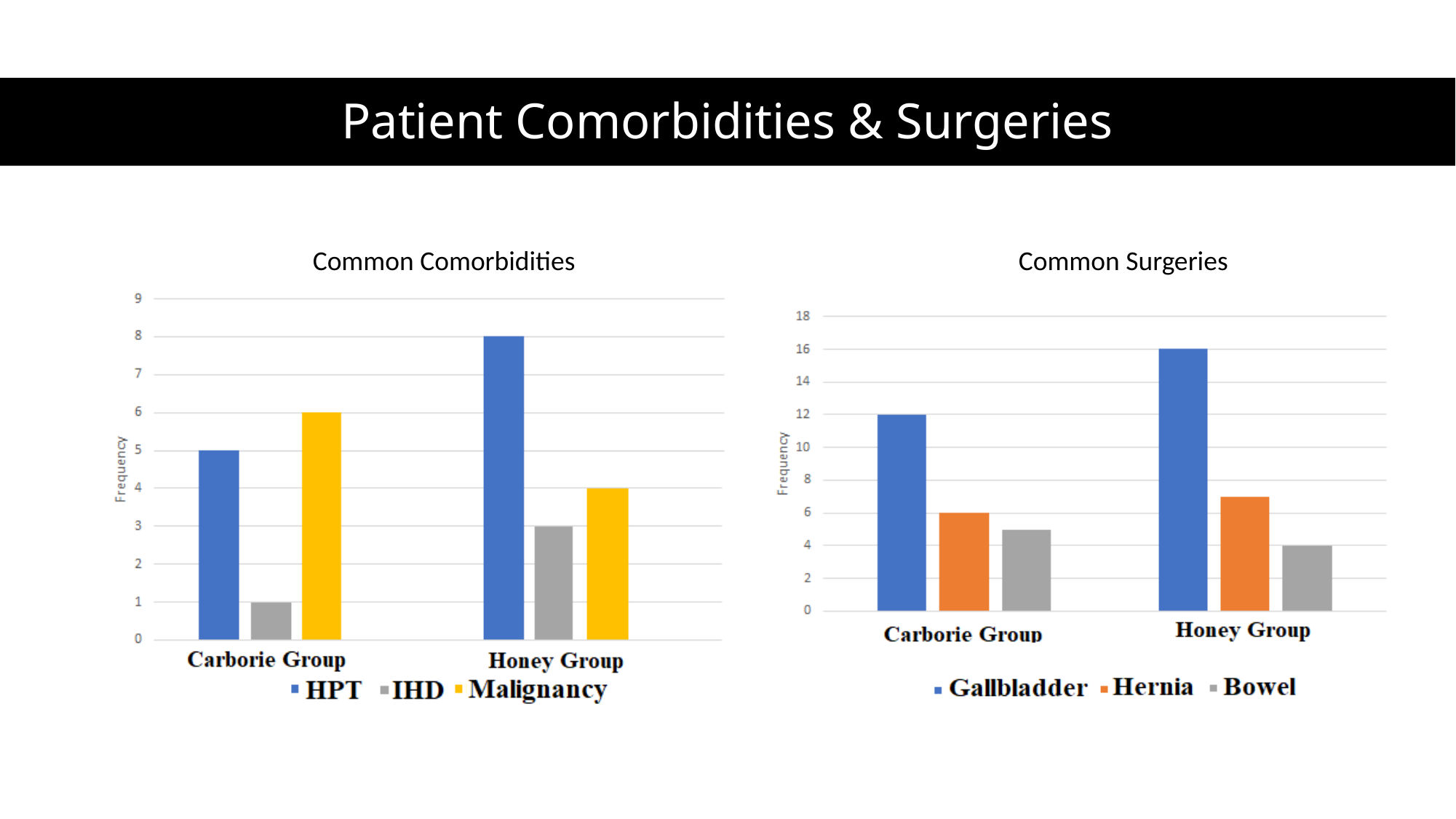
In the Common Surgeries chart, what is the difference between the Gallbladder values for the Honey Group and the Carborie Group? 4 In the Common Surgeries chart, is the Hernia value for the Honey Group greater or less than 6? greater In the Common Comorbidities chart, what is the IHD value for the Carborie Group? 1 In the Common Surgeries chart, what is the Hernia value for the Carborie Group? 6 In the Common Comorbidities chart, what is the Malignancy value for the Carborie Group? 6 What kind of chart is the Common Surgeries chart? Bar chart In the Common Comorbidities chart, how many series does the legend list? 3 In the Common Surgeries chart, which series has the highest value for the Carborie Group? Gallbladder In the Common Comorbidities chart, what is the difference between the HPT values for the Honey Group and the Carborie Group? 3 In the Common Comorbidities chart, which series has the lowest value for the Honey Group? IHD In the Common Surgeries chart, what is the Gallbladder value for the Honey Group? 16 In the Common Comorbidities chart, what is the HPT value for the Honey Group? 8